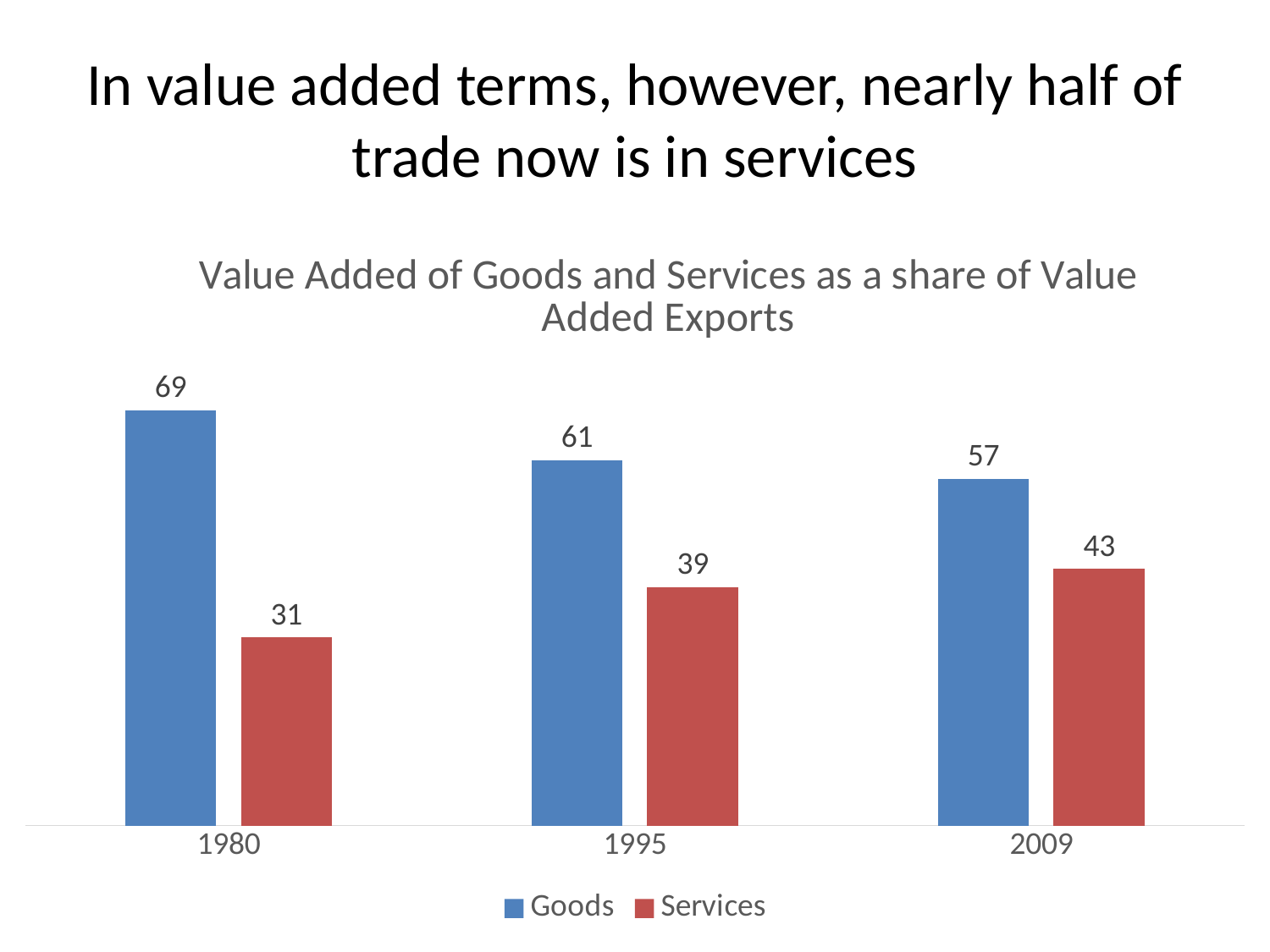
In which year is the Services value lowest? 1980 In which year is the Goods value highest? 1980 What is the difference between the Services values in 2009 and 1980? 12 How many series does the legend list? 2 What kind of chart is shown? Bar chart What is the difference between the Goods and Services values in 2009? 14 Which is larger in 1995, Goods or Services? Goods What is the value for Services in 1995? 39 What is the value for Services in 2009? 43 Does the Services value rise or fall from 1980 to 2009? Rise What is the value for Goods in 1980? 69 How many years are shown on the x axis? 3